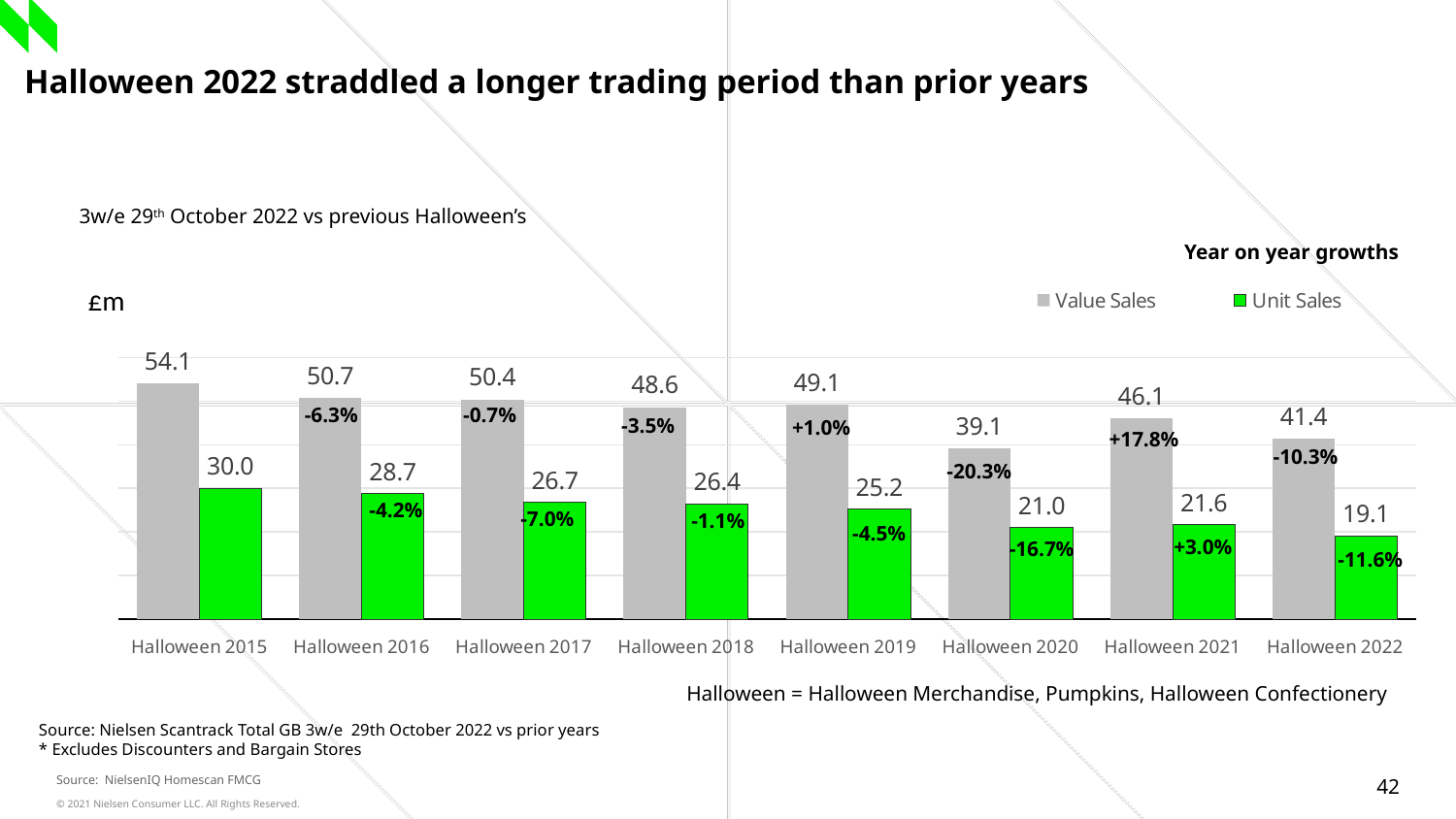
Which Halloween has the lowest Value Sales? Halloween 2020 What is the difference in Value Sales between Halloween 2015 and Halloween 2022? 12.7 Which Halloween has the lowest Unit Sales? Halloween 2022 What unit is shown for the chart's values? £m What kind of chart is shown on the slide? Bar chart What is the Value Sales figure for Halloween 2015? 54.1 How many series does the legend list? 2 What is the Unit Sales figure for Halloween 2022? 19.1 What is the Value Sales figure for Halloween 2020? 39.1 How many Halloween periods are shown on the x axis? 8 Which is larger, Value Sales for Halloween 2021 or Value Sales for Halloween 2022? Halloween 2021 Which Halloween has the highest Value Sales? Halloween 2015